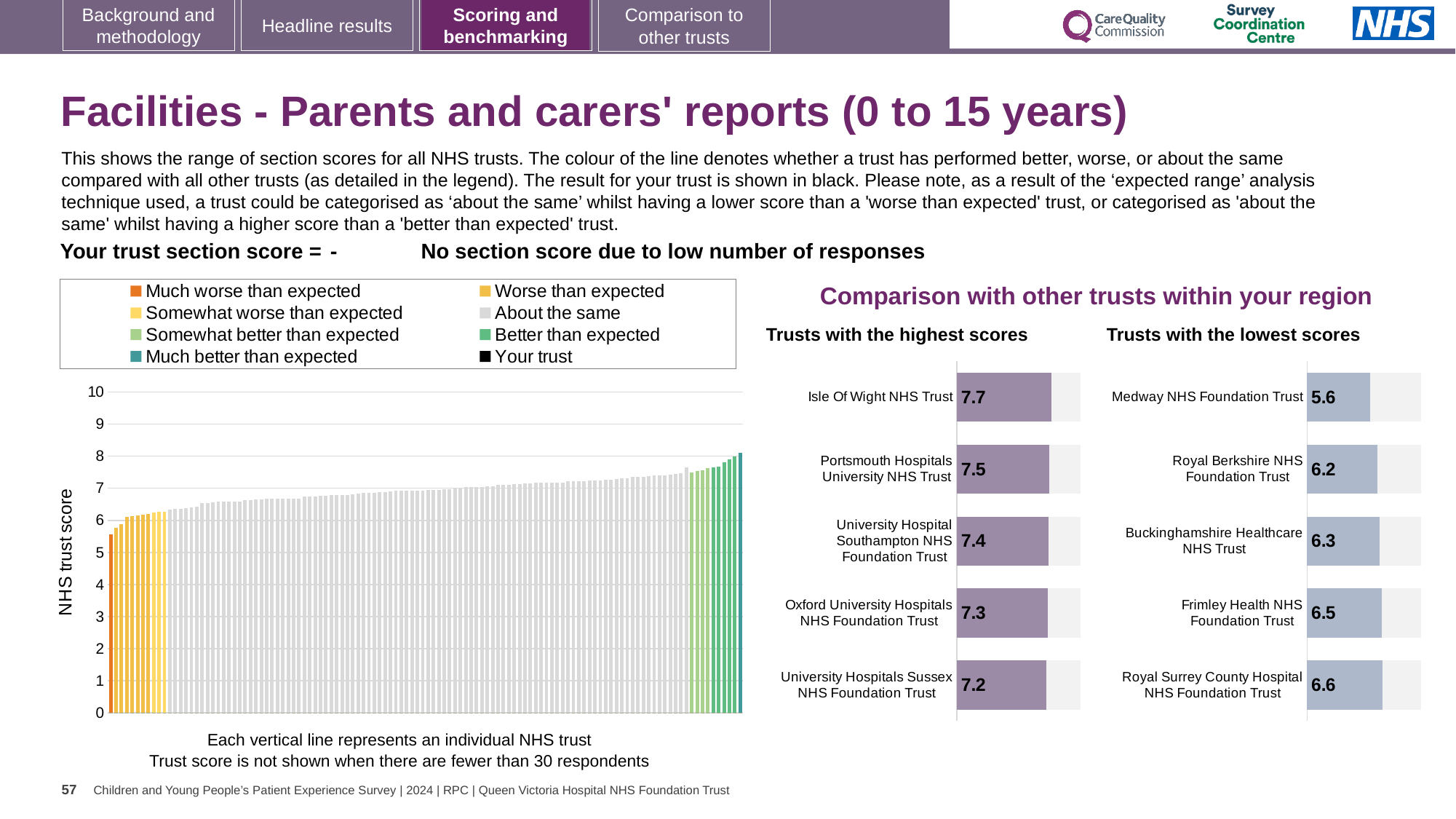
In the 'Trusts with the lowest scores' chart, what is the difference between the scores of Royal Surrey County Hospital NHS Foundation Trust and Medway NHS Foundation Trust? 1.0 In the 'Trusts with the highest scores' chart, what is the score for Isle Of Wight NHS Trust? 7.7 Which is larger: the score for Portsmouth Hospitals University NHS Trust in the highest-scores chart or the score for Royal Berkshire NHS Foundation Trust in the lowest-scores chart? Portsmouth Hospitals University NHS Trust How many entries does the legend of the main chart on the left list? 8 In the 'Trusts with the lowest scores' chart, what is the score for Medway NHS Foundation Trust? 5.6 In the 'Trusts with the highest scores' chart, which trust has the highest score? Isle Of Wight NHS Trust How many trusts are shown in the 'Trusts with the lowest scores' chart? 5 In the main chart on the left showing all NHS trusts, do the bar values rise or fall from left to right? rise In the 'Trusts with the highest scores' chart, what is the score for Oxford University Hospitals NHS Foundation Trust? 7.3 In the 'Trusts with the lowest scores' chart, which trust has the lowest score? Medway NHS Foundation Trust In the 'Trusts with the highest scores' chart, what is the difference between the scores of Isle Of Wight NHS Trust and University Hospitals Sussex NHS Foundation Trust? 0.5 In the 'Trusts with the lowest scores' chart, what is the score for Frimley Health NHS Foundation Trust? 6.5